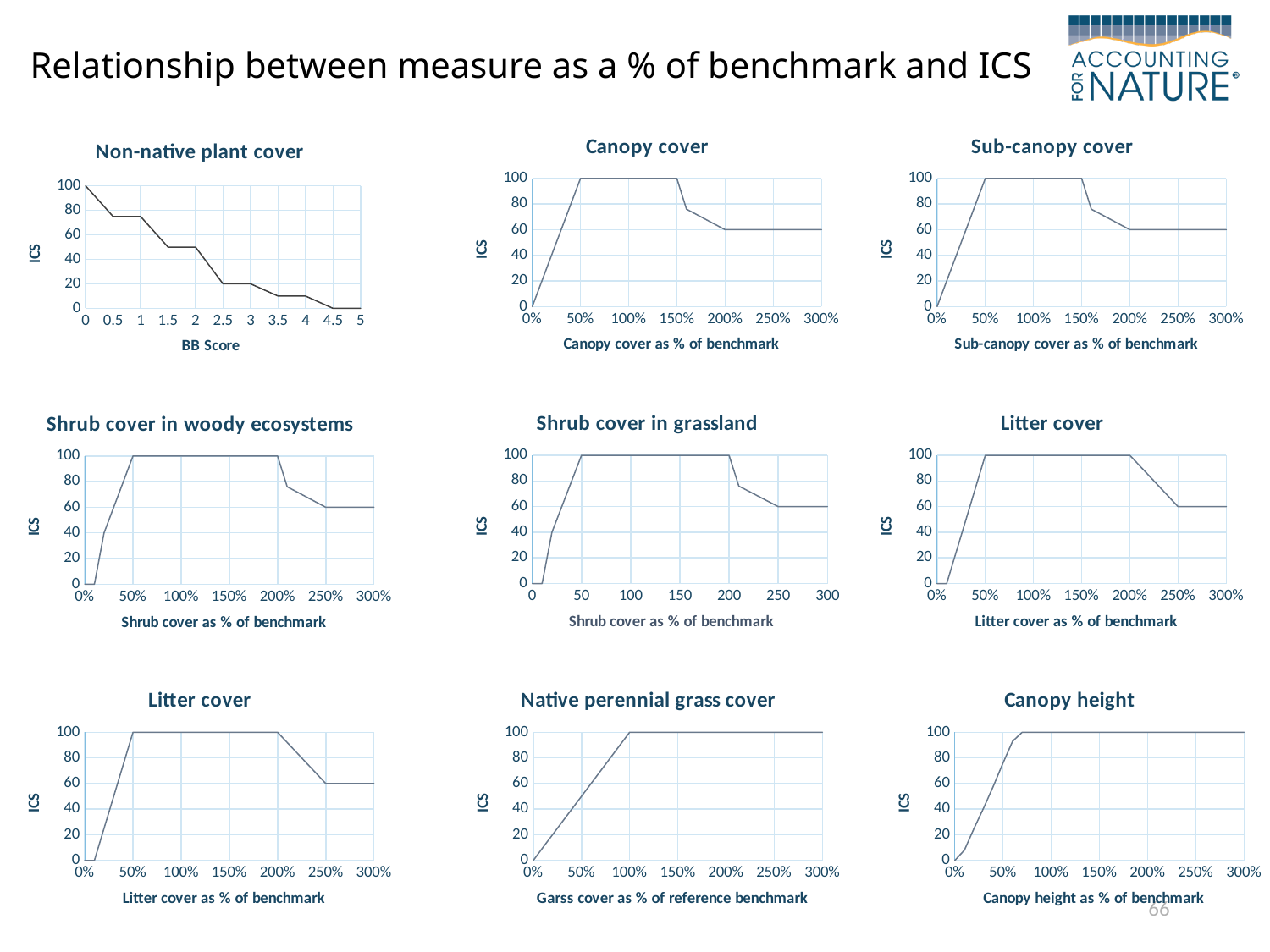
In the 'Canopy cover' chart, what is the ICS value when canopy cover is 100% of benchmark? 100 In the 'Litter cover' chart in the middle row, what is the ICS value when litter cover is 250% of benchmark? 60 In the 'Non-native plant cover' chart, does ICS rise or fall as BB Score increases? fall In the 'Canopy cover' chart, what is the ICS value when canopy cover is 300% of benchmark? 60 What is the x-axis title of the 'Native perennial grass cover' chart? Garss cover as % of reference benchmark In the 'Non-native plant cover' chart, what is the ICS value at a BB Score of 0? 100 In the 'Non-native plant cover' chart, what is the ICS value at a BB Score of 5? 0 How many charts are shown on the slide? 9 In the 'Native perennial grass cover' chart, is the ICS value at 50% of benchmark greater or less than 80? less In the 'Non-native plant cover' chart, what is the ICS value at a BB Score of 2.5? 20 In the 'Non-native plant cover' chart, which has the higher ICS value: a BB Score of 1 or a BB Score of 3? BB Score of 1 What kind of chart is the 'Non-native plant cover' chart? line chart